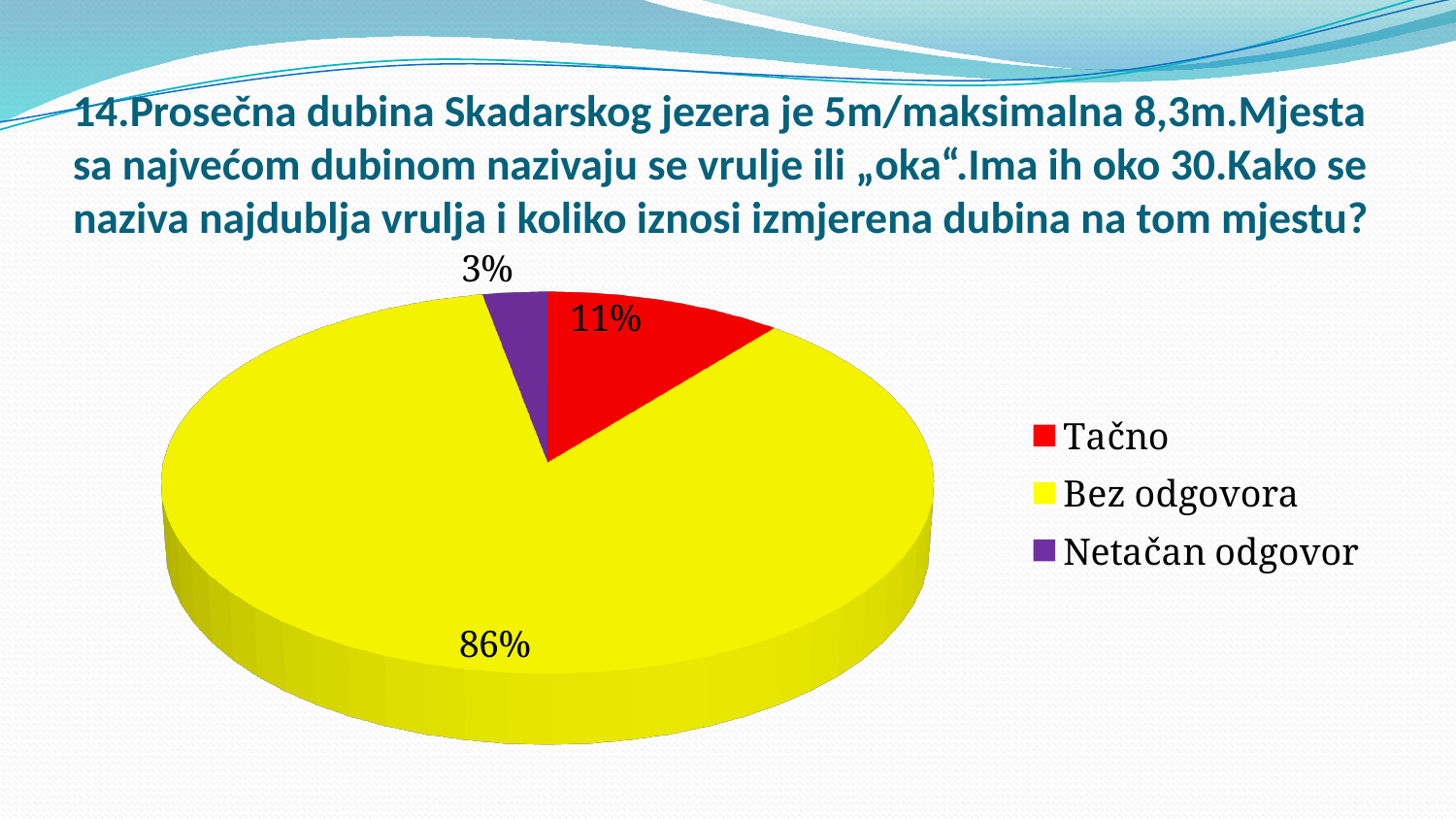
How many categories does the pie chart have? 3 What is the difference between the shares of "Bez odgovora" and "Tačno"? 75% Which category has the largest slice of the pie? Bez odgovora What is the difference between the shares of "Tačno" and "Netačan odgovor"? 8% Which category is shown in red in the legend? Tačno What share of the pie does "Netačan odgovor" have? 3% Which is larger, the share for "Tačno" or the share for "Netačan odgovor"? Tačno Which category has the smallest slice of the pie? Netačan odgovor What share of the pie does "Tačno" have? 11% What kind of chart is shown on the slide? pie chart What share of the pie does "Bez odgovora" have? 86% What colour is the slice for "Bez odgovora"? yellow